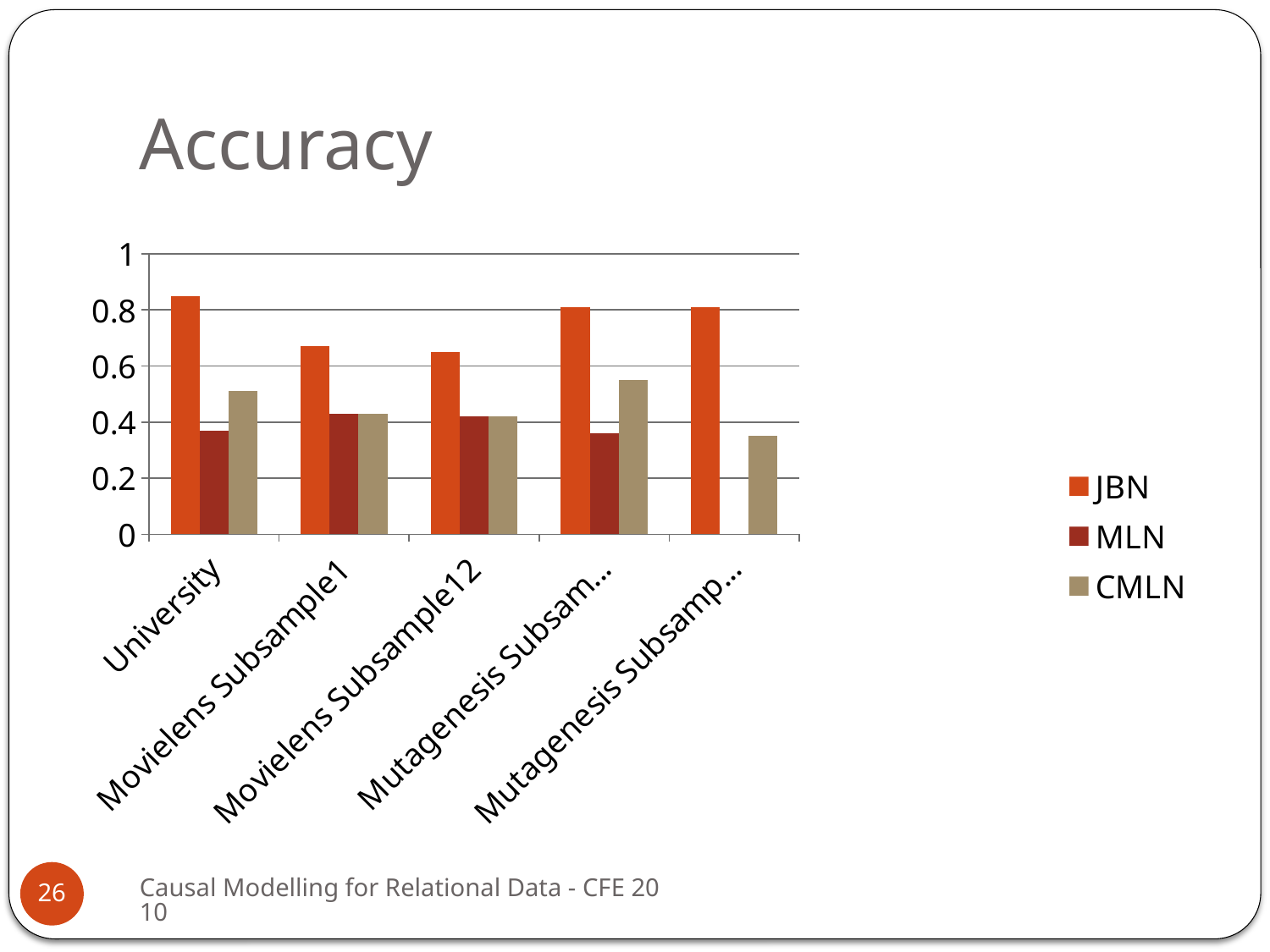
What is the title of the slide? Accuracy How many series does the legend list? 3 For University, which is larger: the JBN value or the CMLN value? JBN Which series has the highest value for Movielens Subsample12? JBN How many categories are shown along the x axis? 5 Is the JBN value for Movielens Subsample1 greater or less than 0.6? greater What kind of chart is shown on the slide? bar chart Is the JBN value for Movielens Subsample12 greater or less than 0.8? less For University, which is larger: the MLN value or the CMLN value? CMLN Is the MLN value for University greater or less than 0.4? less